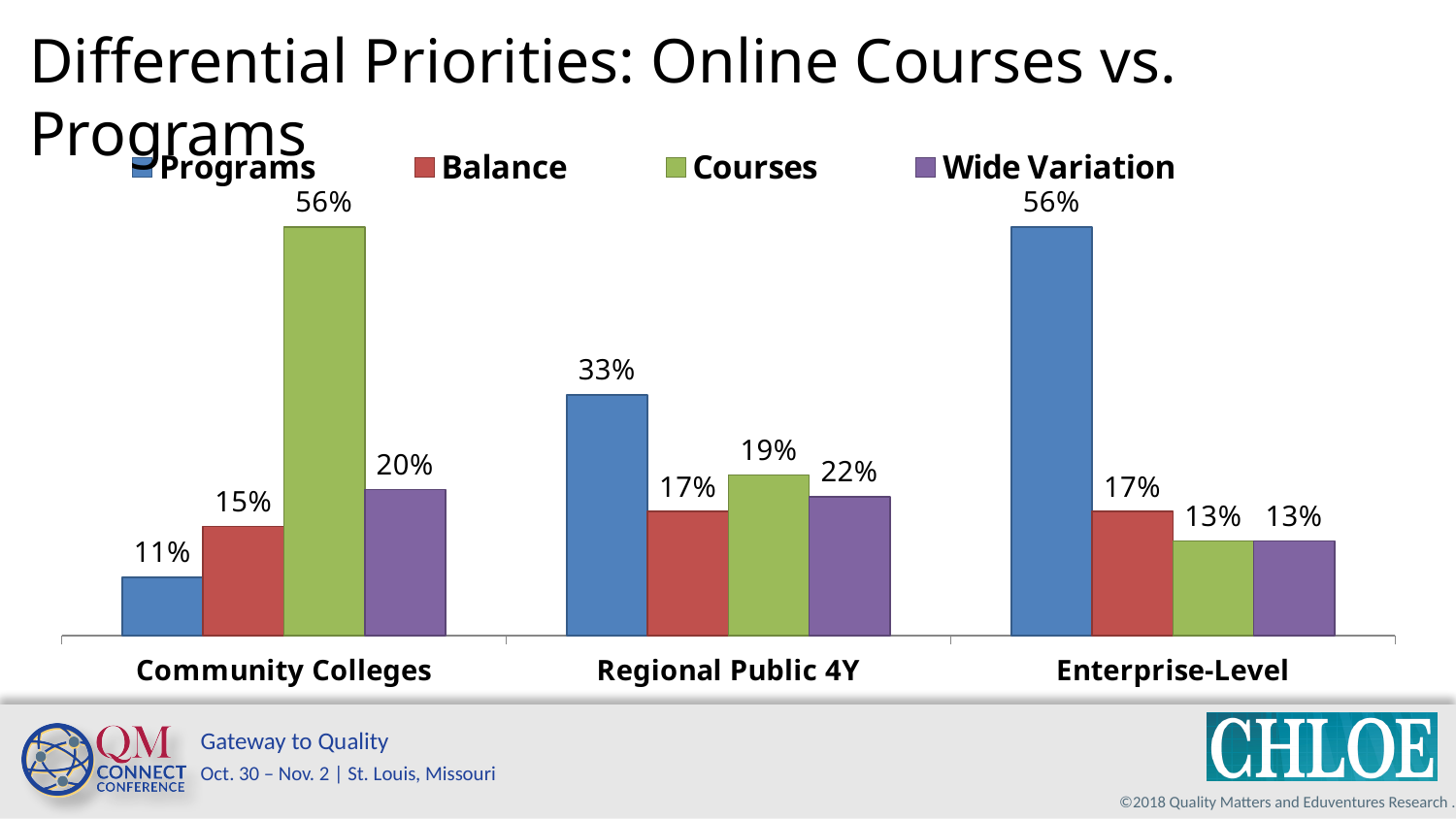
What is the value for Programs at Enterprise-Level? 56% Which is larger at Enterprise-Level: Programs or Balance? Programs Which series has the lowest value at Community Colleges? Programs What kind of chart is shown on the slide? Bar chart Do the Programs values rise or fall from Community Colleges to Enterprise-Level? Rise How many series does the legend list? 4 Which series has the highest value at Regional Public 4Y? Programs How many categories are shown on the x axis? 3 What is the value for Wide Variation at Regional Public 4Y? 22% What is the value for Courses at Community Colleges? 56% What is the value for Balance at Community Colleges? 15% What is the difference between the Courses value and the Programs value at Community Colleges? 45%